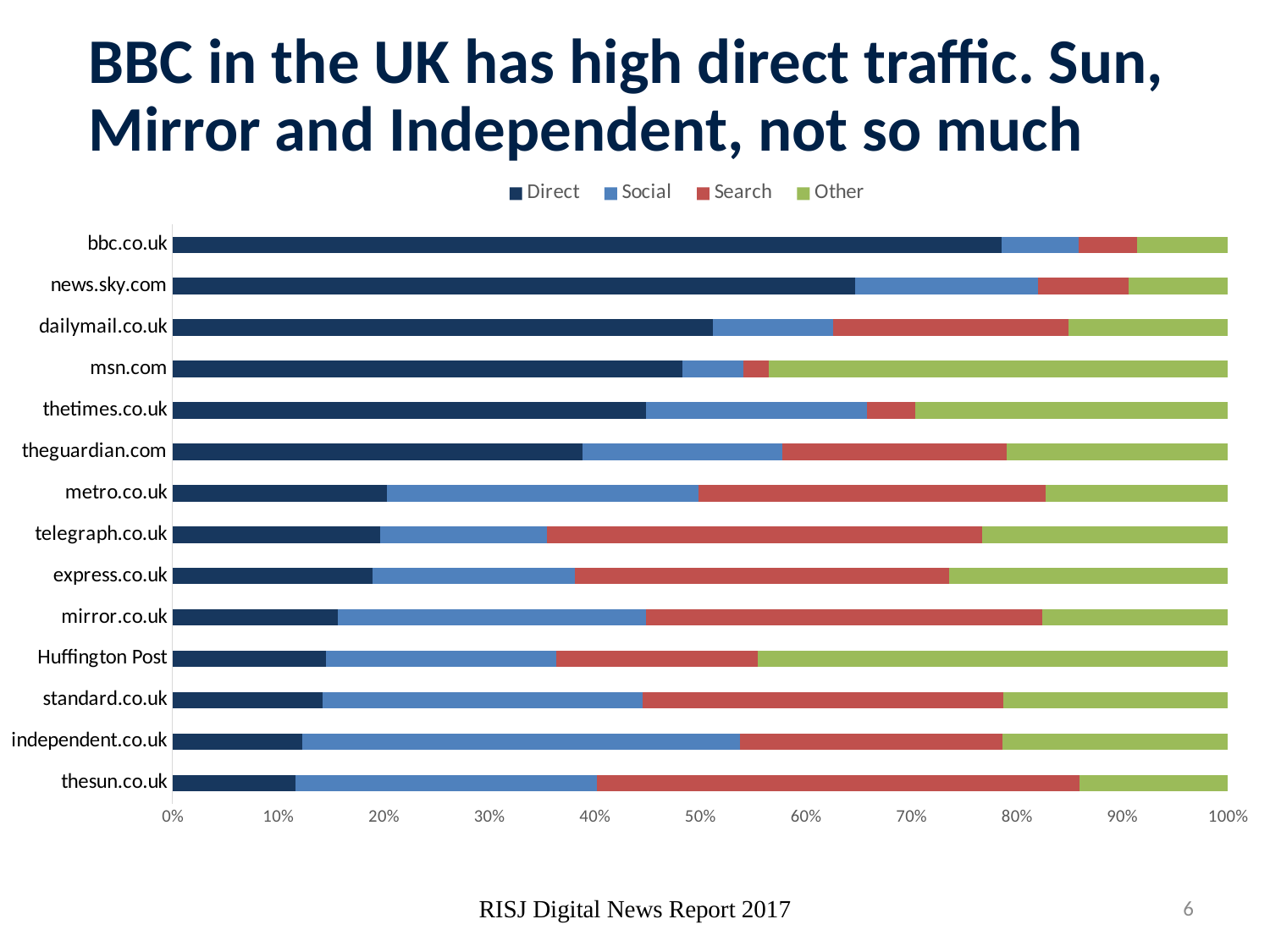
How many news sites are listed on the chart? 14 What kind of chart is shown on the slide? Stacked bar chart Is the Direct share for bbc.co.uk greater or less than 70%? greater How many series does the legend list? 4 Which news site has the largest Social share? independent.co.uk Which has a larger Direct share, bbc.co.uk or news.sky.com? bbc.co.uk What are the four traffic sources listed in the legend? Direct, Social, Search, Other For telegraph.co.uk, which is larger, the Search share or the Social share? Search Is the Direct share for thesun.co.uk greater or less than 20%? less Which news site has the largest Other share? Huffington Post Which news site has the largest Direct share? bbc.co.uk